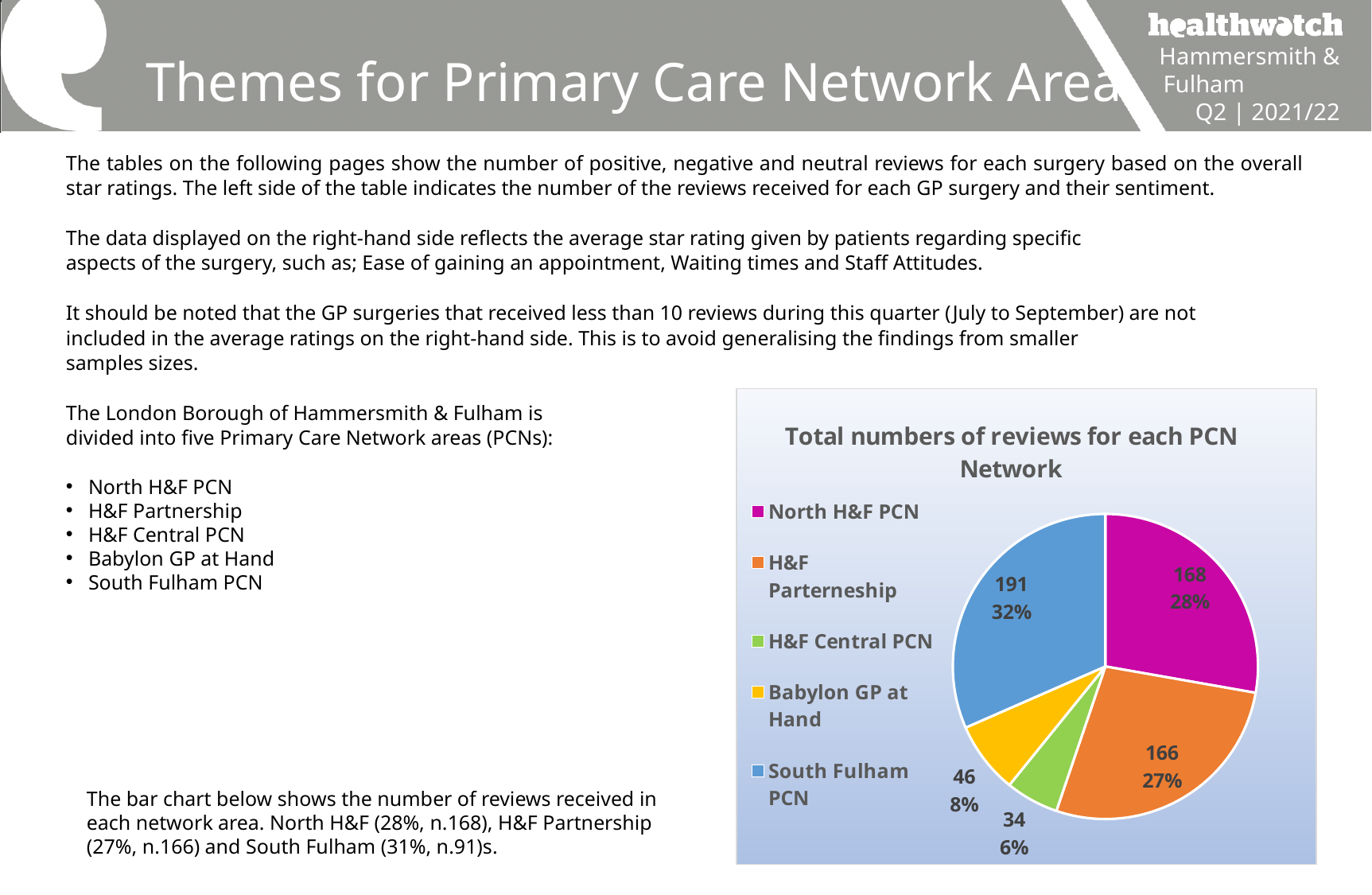
What share of the pie does Babylon GP at Hand represent? 8% How many reviews does the pie chart show for H&F Central PCN? 34 How many reviews does the pie chart show for North H&F PCN? 168 What is the title of the chart? Total numbers of reviews for each PCN Network Which PCN has the largest number of reviews in the pie chart? South Fulham PCN How many categories does the legend of the pie chart list? 5 How many reviews does the pie chart show for South Fulham PCN? 191 What type of chart is shown on the slide? Pie chart What is the difference in the number of reviews between South Fulham PCN and North H&F PCN? 23 Which PCN has the smallest number of reviews in the pie chart? H&F Central PCN Which has more reviews in the pie chart, Babylon GP at Hand or H&F Central PCN? Babylon GP at Hand What share of the pie does H&F Parterneship represent? 27%